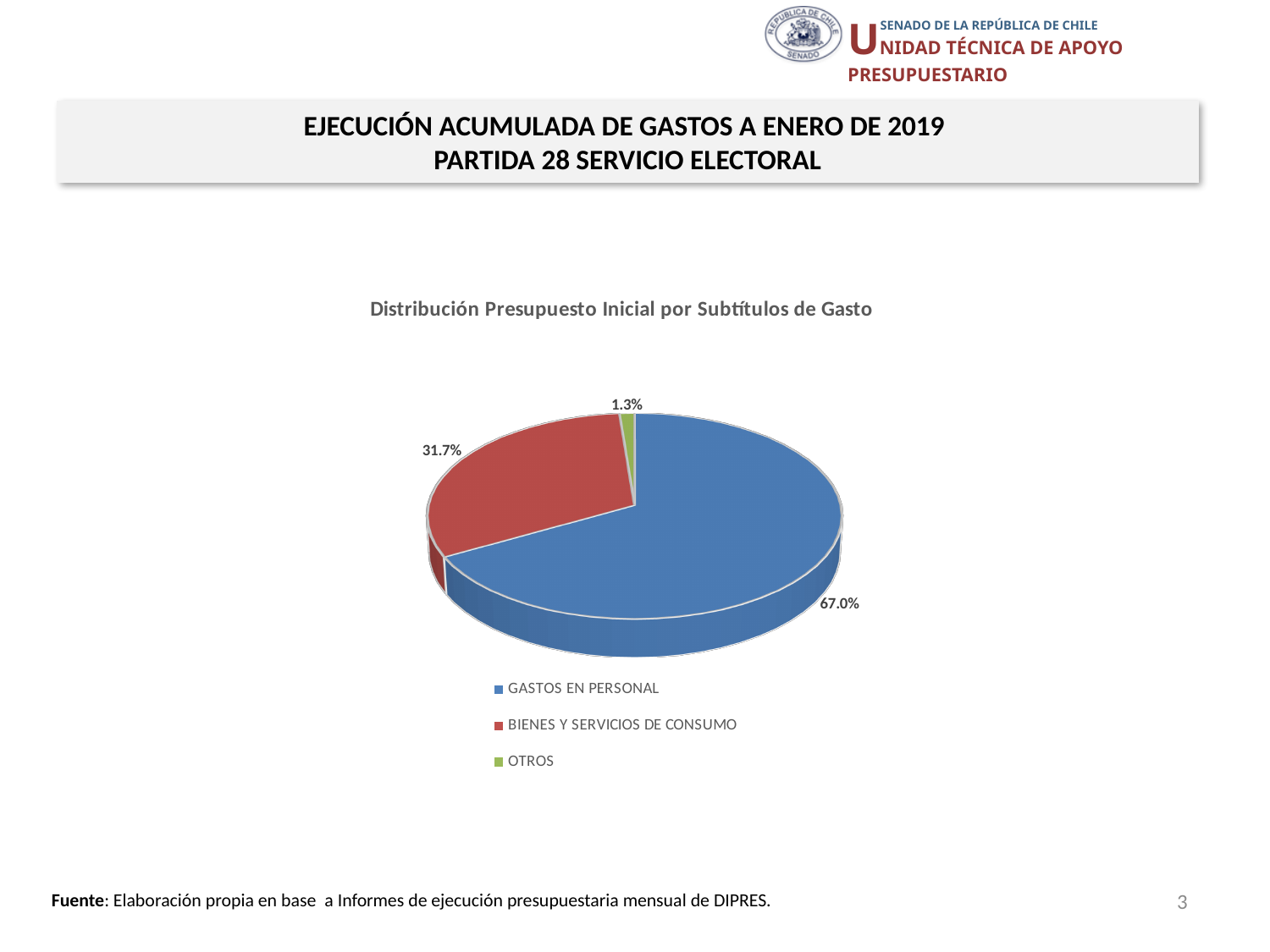
What is the title of the chart? Distribución Presupuesto Inicial por Subtítulos de Gasto What kind of chart is shown on the slide? pie chart Is the share for GASTOS EN PERSONAL greater or less than 50%? greater Which category has the largest slice of the pie? GASTOS EN PERSONAL What share of the pie does OTROS represent? 1.3% What share of the pie does BIENES Y SERVICIOS DE CONSUMO represent? 31.7% Which category has the smallest slice of the pie? OTROS How many categories does the pie chart show? 3 What colour is the slice for BIENES Y SERVICIOS DE CONSUMO? red What is the difference in percentage points between GASTOS EN PERSONAL and BIENES Y SERVICIOS DE CONSUMO? 35.3 percentage points Which is larger, the share for BIENES Y SERVICIOS DE CONSUMO or the share for OTROS? BIENES Y SERVICIOS DE CONSUMO What share of the pie does GASTOS EN PERSONAL represent? 67.0%